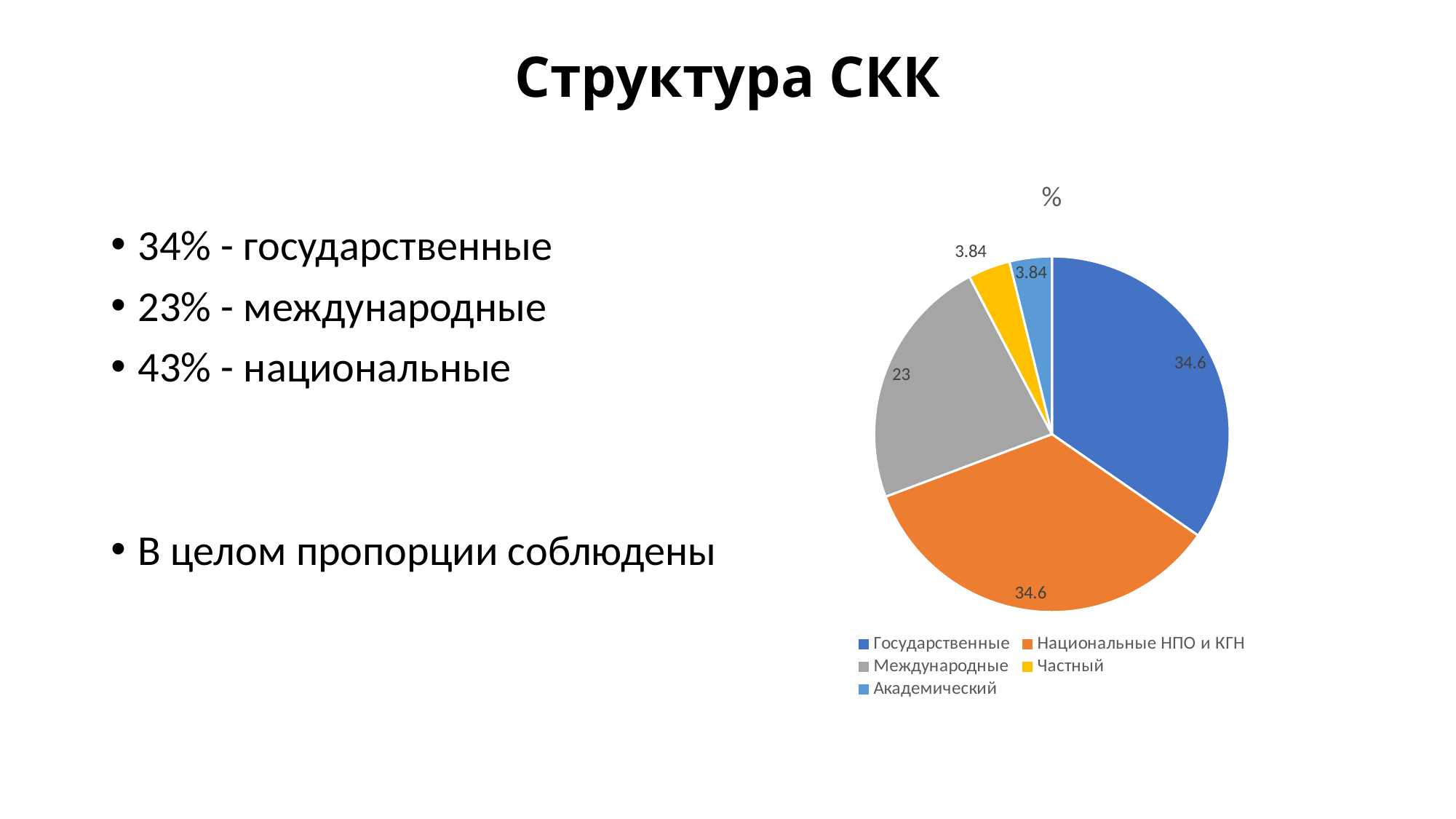
Which is larger in the pie chart, Международные or Частный? Международные What kind of chart is shown on the slide? pie chart Which colour represents Международные in the pie chart? grey What is the value for Национальные НПО и КГН in the pie chart? 34.6 What is the title of the chart? % How many slices does the pie chart have? 5 What is the value for Частный in the pie chart? 3.84 What is the value for Академический in the pie chart? 3.84 What is the value for Государственные in the pie chart? 34.6 How many entries does the chart legend list? 5 What is the value for Международные in the pie chart? 23 What is the difference between the values for Государственные and Международные? 11.6